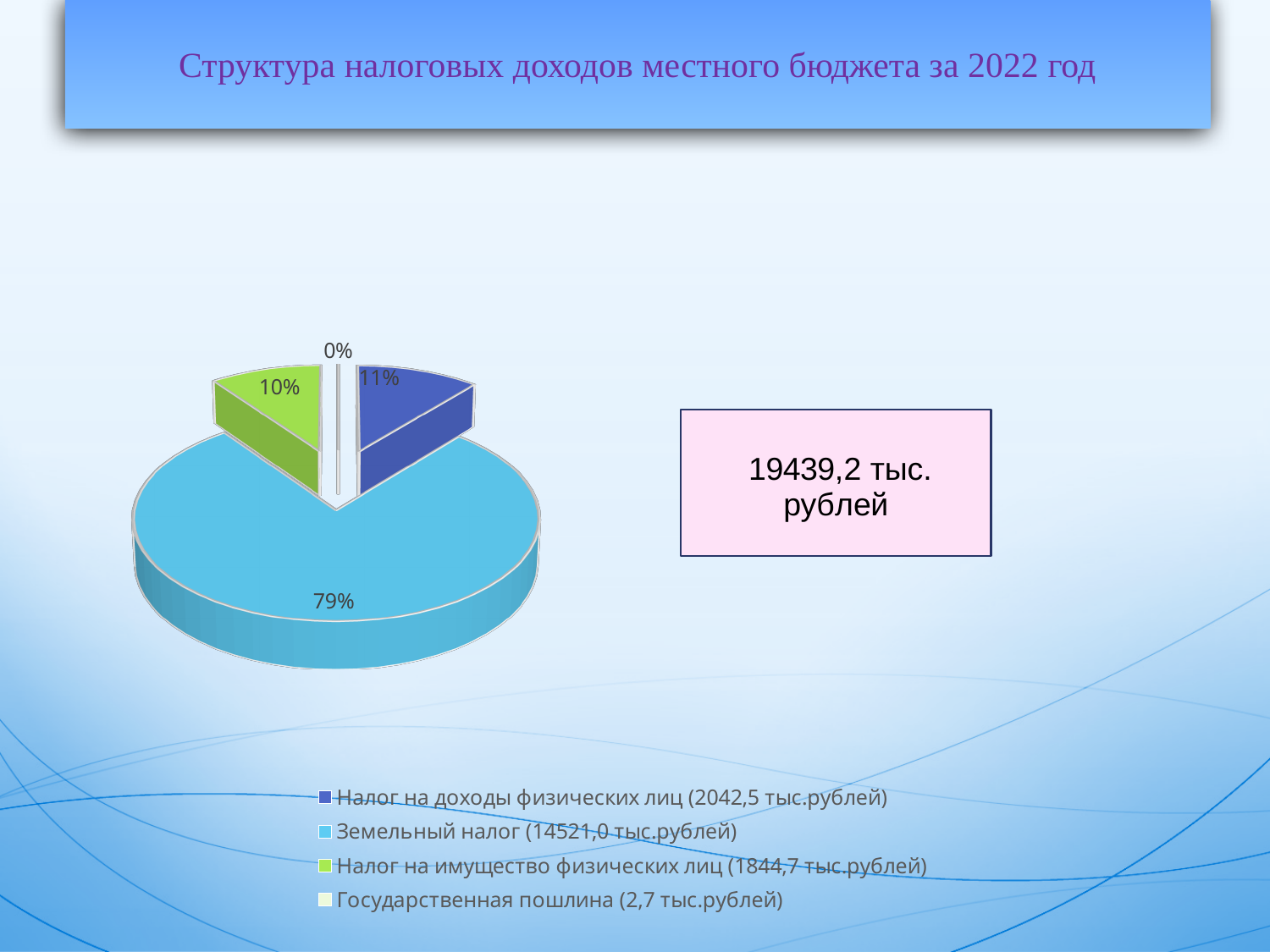
What percentage is shown for Государственная пошлина? 0% What kind of chart is shown on the slide? Pie chart Which is larger: the share of Налог на доходы физических лиц or the share of Налог на имущество физических лиц? Налог на доходы физических лиц What amount in тыс.рублей does the legend give for Земельный налог? 14521,0 тыс.рублей What is the title of the slide containing the chart? Структура налоговых доходов местного бюджета за 2022 год Which category has the smallest slice of the pie? Государственная пошлина What share of the pie does Налог на имущество физических лиц have? 10% Which category has the largest slice of the pie? Земельный налог What share of the pie does Земельный налог have? 79% How many categories does the pie chart have? 4 What is the difference in percentage points between the share of Земельный налог and the share of Налог на доходы физических лиц? 68 percentage points What share of the pie does Налог на доходы физических лиц have? 11%